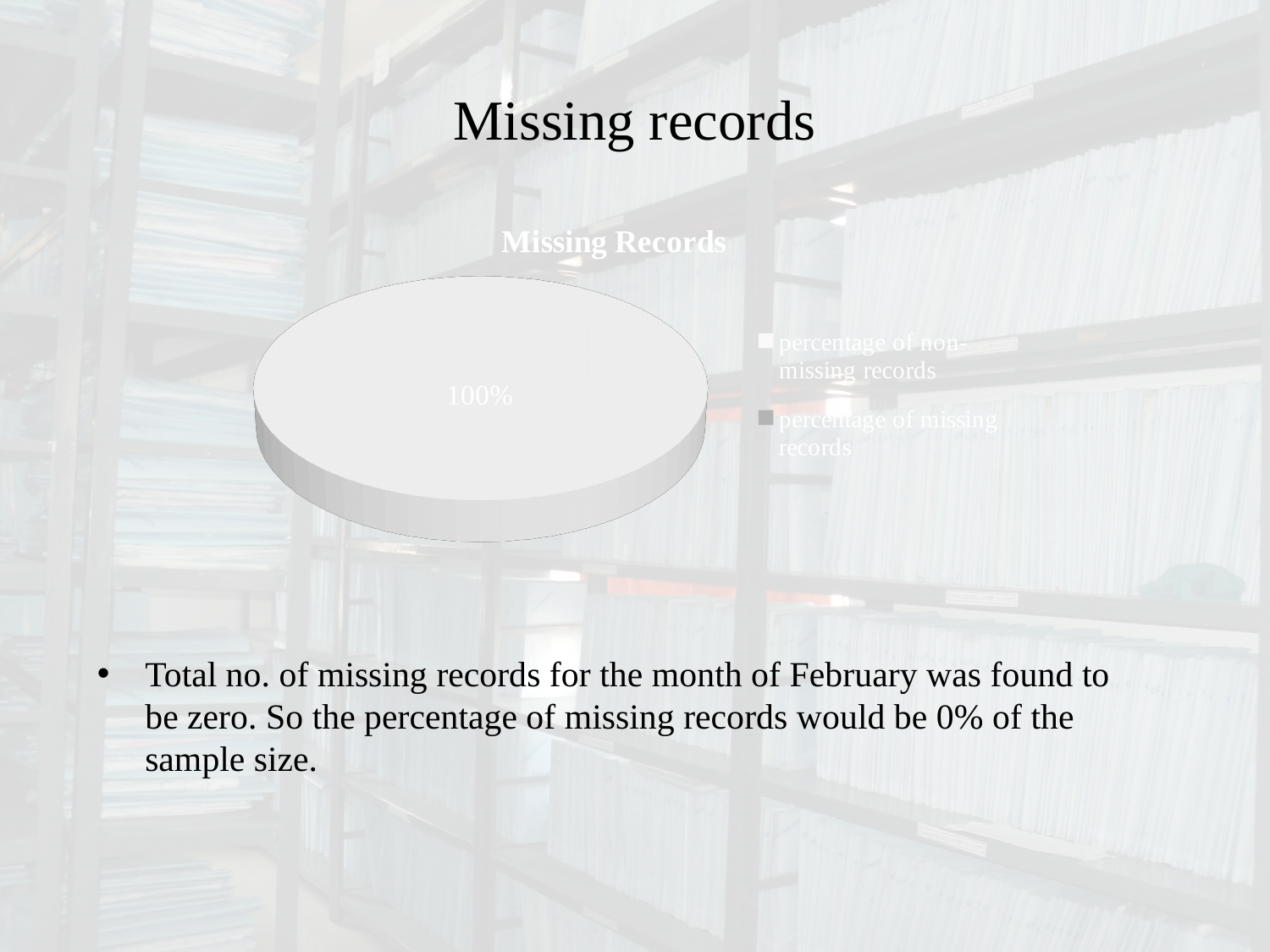
How many entries does the chart's legend list? 2 How many slices are visibly drawn in the pie chart? 1 What share of the pie does the 'percentage of non-missing records' slice take up? 100% What are the two legend entries of the chart? percentage of non-missing records; percentage of missing records What percentage label is printed on the visible slice of the pie chart? 100% What kind of chart is shown on the slide? pie chart Which legend entry corresponds to the slice that fills the entire pie? percentage of non-missing records What is the title of the chart? Missing Records